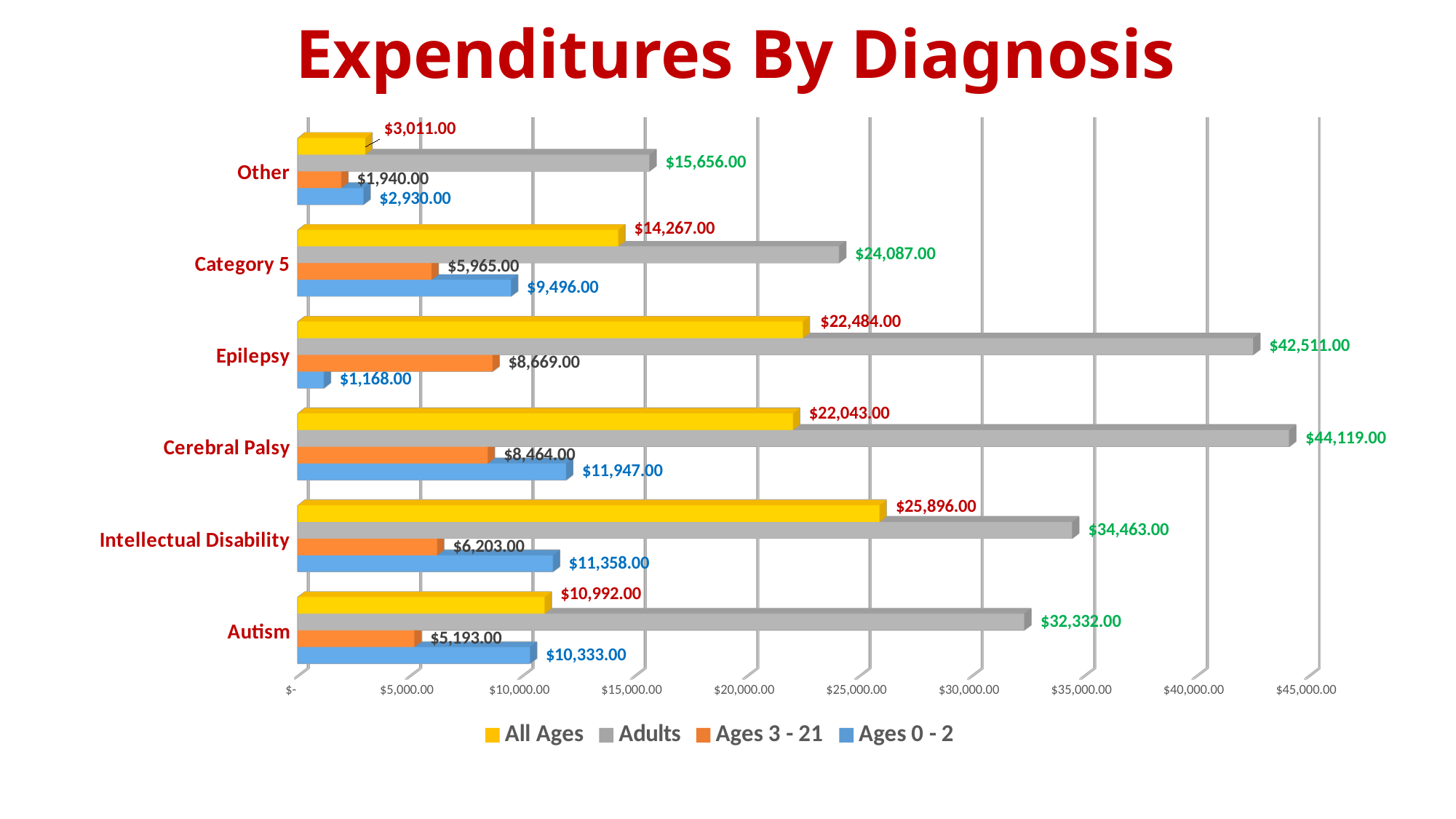
Which diagnosis has the lowest All Ages expenditure? Other What is the Adults expenditure for Cerebral Palsy? $44,119.00 Which diagnosis has the highest Adults expenditure? Cerebral Palsy Which is larger for Category 5: the Ages 0 - 2 expenditure or the Ages 3 - 21 expenditure? Ages 0 - 2 What is the difference between the Adults and All Ages expenditures for Epilepsy? $20,027.00 What is the Ages 0 - 2 expenditure for Epilepsy? $1,168.00 What is the All Ages expenditure for Intellectual Disability? $25,896.00 How many series does the legend list? 4 What is the Ages 3 - 21 expenditure for Autism? $5,193.00 What kind of chart is shown on the slide? Bar chart What is the title of the chart? Expenditures By Diagnosis How many diagnosis categories are shown on the chart? 6